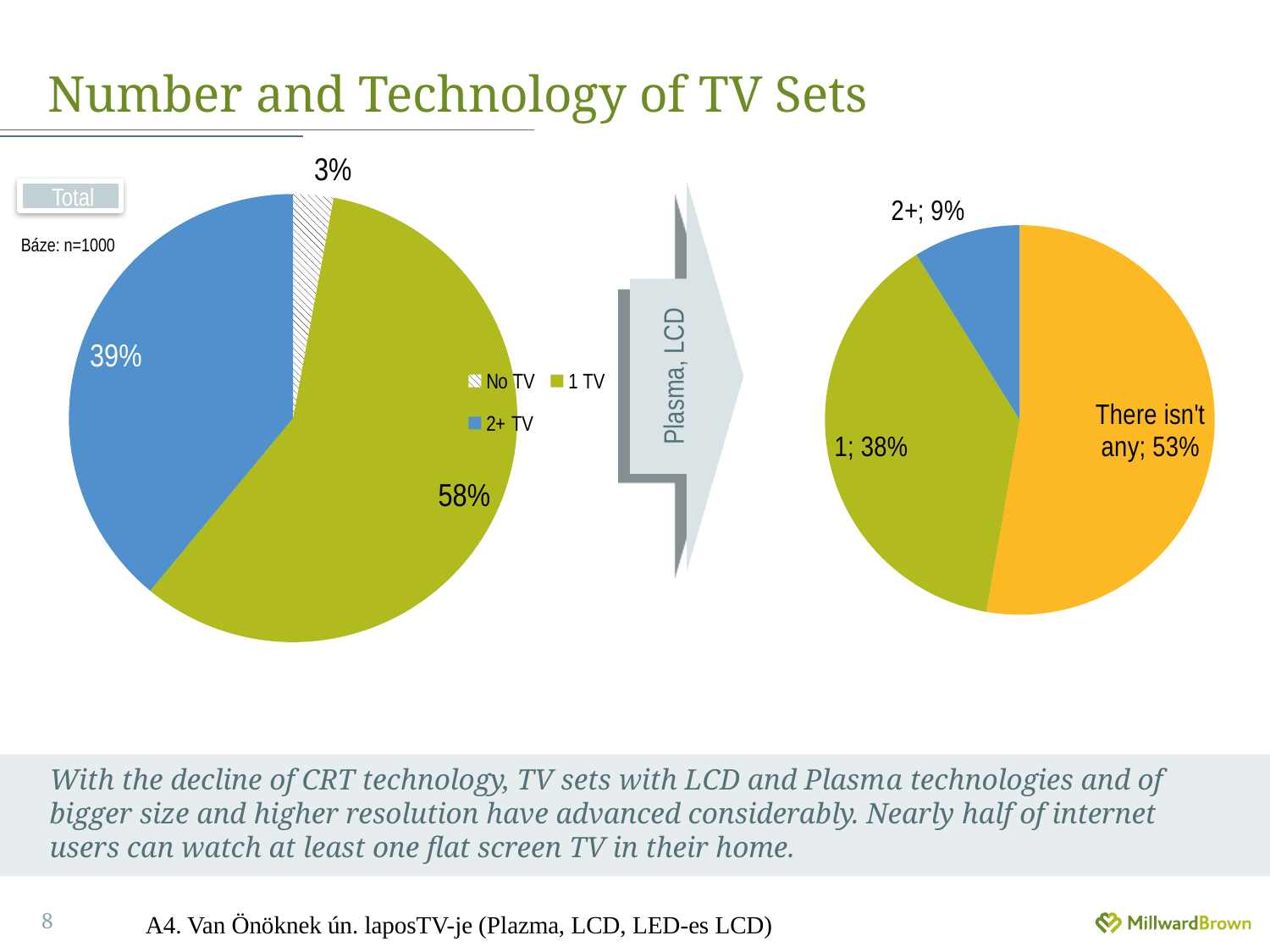
In the right pie chart (Plasma, LCD), which is larger: the share for '1' or the share for '2+'? 1 In the left pie chart, what is the difference in percentage points between the 1 TV and 2+ TV shares? 19 In the left pie chart, which category has the largest share? 1 TV In the right pie chart (Plasma, LCD), what share of respondents have 1 flat screen TV? 38% What type of chart is the left chart on the slide? pie chart How many entries does the legend of the left pie chart list? 3 In the left pie chart, what share of respondents have no TV? 3% In the right pie chart (Plasma, LCD), which category has the smallest share? 2+ In the right pie chart (Plasma, LCD), what share of respondents have no flat screen TV ('There isn't any')? 53% In the left pie chart, which category has the smallest share? No TV In the left pie chart, what share of respondents have 1 TV? 58% In the left pie chart, what share of respondents have 2+ TVs? 39%